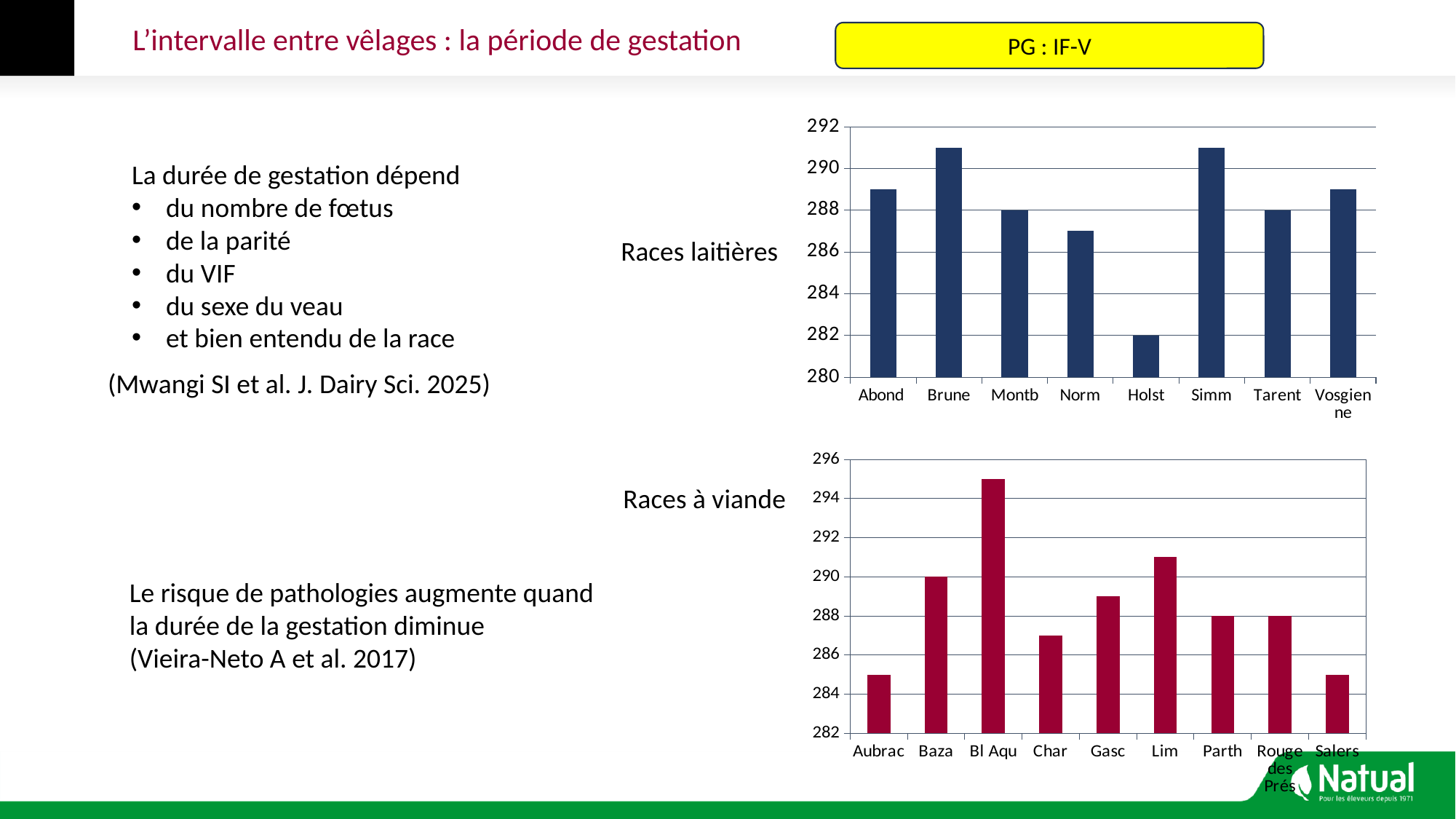
In the 'Races à viande' chart, which breed has the highest value? Bl Aqu In the 'Races laitières' chart, how many breeds are plotted? 8 In the 'Races laitières' chart, which is larger, the value for Brune or the value for Tarent? Brune In the 'Races à viande' chart, what is the value for Baza? 290 In the 'Races laitières' chart, what kind of chart is shown? bar chart In the 'Races laitières' chart, what is the value for Montb? 288 In the 'Races à viande' chart, is the value for Lim greater or less than 290? greater In the 'Races laitières' chart, which breed has the lowest value? Holst In the 'Races laitières' chart, what is the difference between the values for Montb and Holst? 6 In the 'Races à viande' chart, how many breeds are plotted? 9 In the 'Races laitières' chart, is the value for Norm greater or less than 288? less In the 'Races laitières' chart, what is the value for Holst? 282